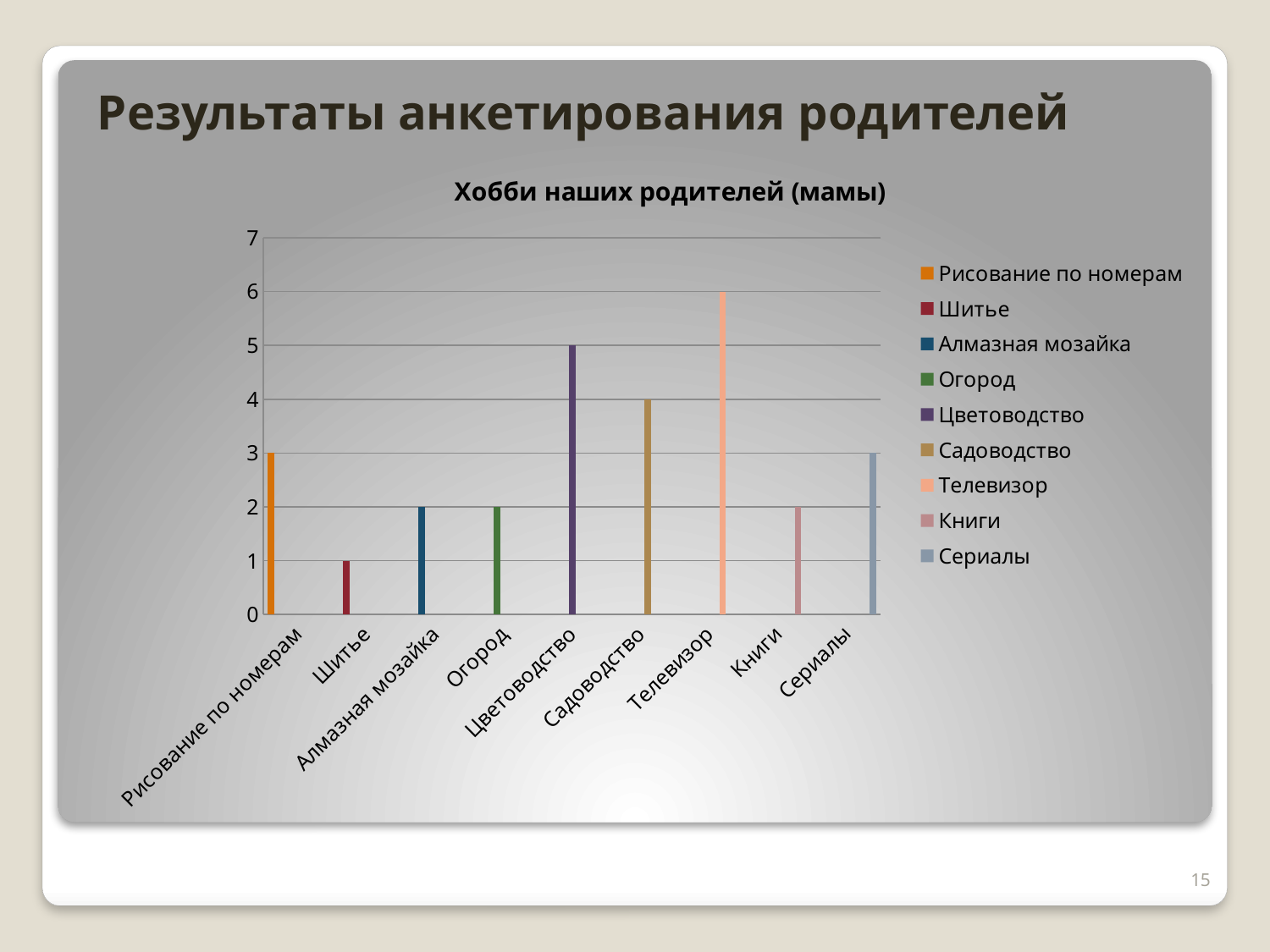
What type of chart is shown on the slide? bar chart Is the value for Садоводство greater or less than 3? greater What is the title of the chart? Хобби наших родителей (мамы) Which category has the highest value in the chart? Телевизор What is the value for Рисование по номерам? 3 How many categories are shown on the x axis of the chart? 9 What is the value for Телевизор? 6 What is the value for Цветоводство? 5 What is the difference between the values for Телевизор and Садоводство? 2 How many entries does the chart's legend list? 9 Which category has the lowest value in the chart? Шитье Which is larger, the value for Цветоводство or the value for Сериалы? Цветоводство